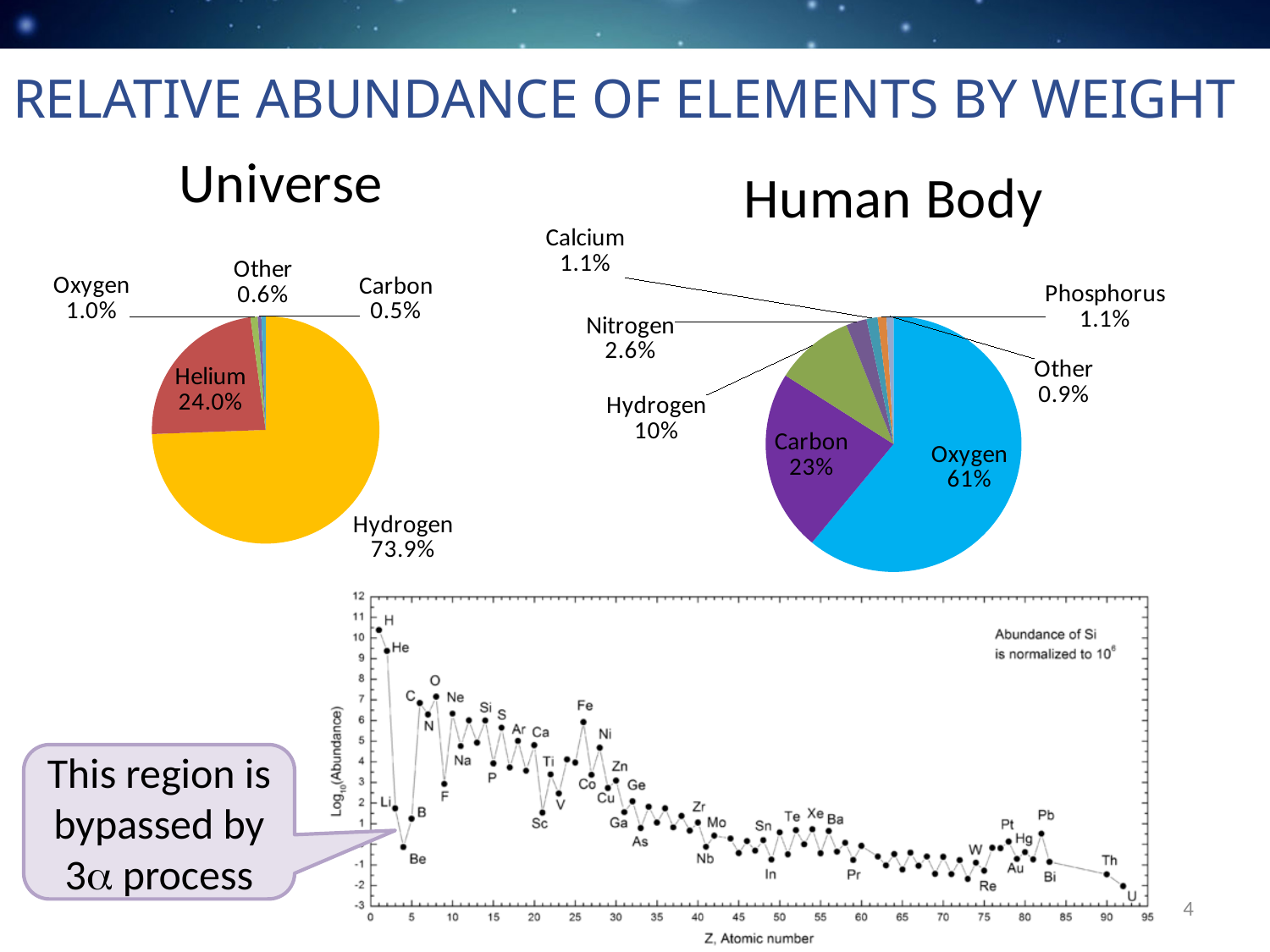
In the Human Body pie chart, what is the share for Oxygen? 61% In the Universe pie chart, which element has the smallest share? Carbon In the Universe pie chart, what is the share for Helium? 24.0% In the bottom chart of abundance versus atomic number, is the Log10(Abundance) value for H greater or less than 10? greater In the Human Body pie chart, how many slices are there? 7 In the Human Body pie chart, which element has the largest share? Oxygen In the Universe pie chart, how many slices are there? 5 In the Universe pie chart, what is the difference between the Hydrogen and Helium shares? 49.9% In the Universe pie chart, what is the share for Hydrogen? 73.9% What is the x-axis label of the bottom chart? Z, Atomic number In the Human Body pie chart, what is the share for Nitrogen? 2.6% In the Human Body pie chart, which is larger, the share for Carbon or the share for Hydrogen? Carbon